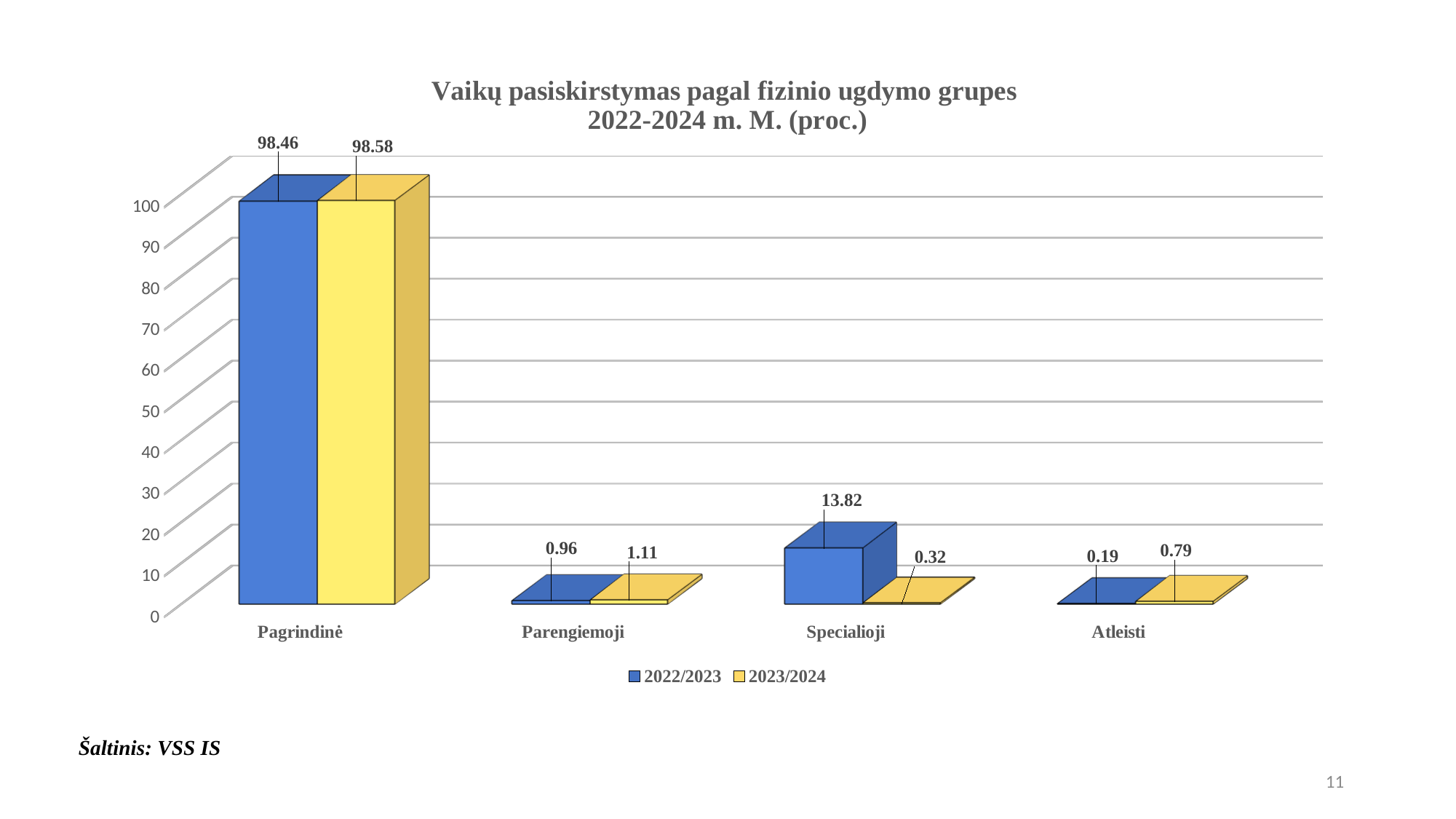
What is the value for Pagrindinė in the 2023/2024 series? 98.58 What is the value for Atleisti in the 2023/2024 series? 0.79 What kind of chart is shown on the slide? Bar chart Which category has the highest value in the 2023/2024 series? Pagrindinė How many series does the legend list? 2 What is the value for Pagrindinė in the 2022/2023 series? 98.46 What is the difference between the 2022/2023 and 2023/2024 values for Specialioji? 13.5 What is the value for Specialioji in the 2022/2023 series? 13.82 Which is larger for Specialioji: the 2022/2023 value or the 2023/2024 value? 2022/2023 Which category has the lowest value in the 2022/2023 series? Atleisti How many categories are shown on the x axis? 4 What is the value for Parengiemoji in the 2023/2024 series? 1.11